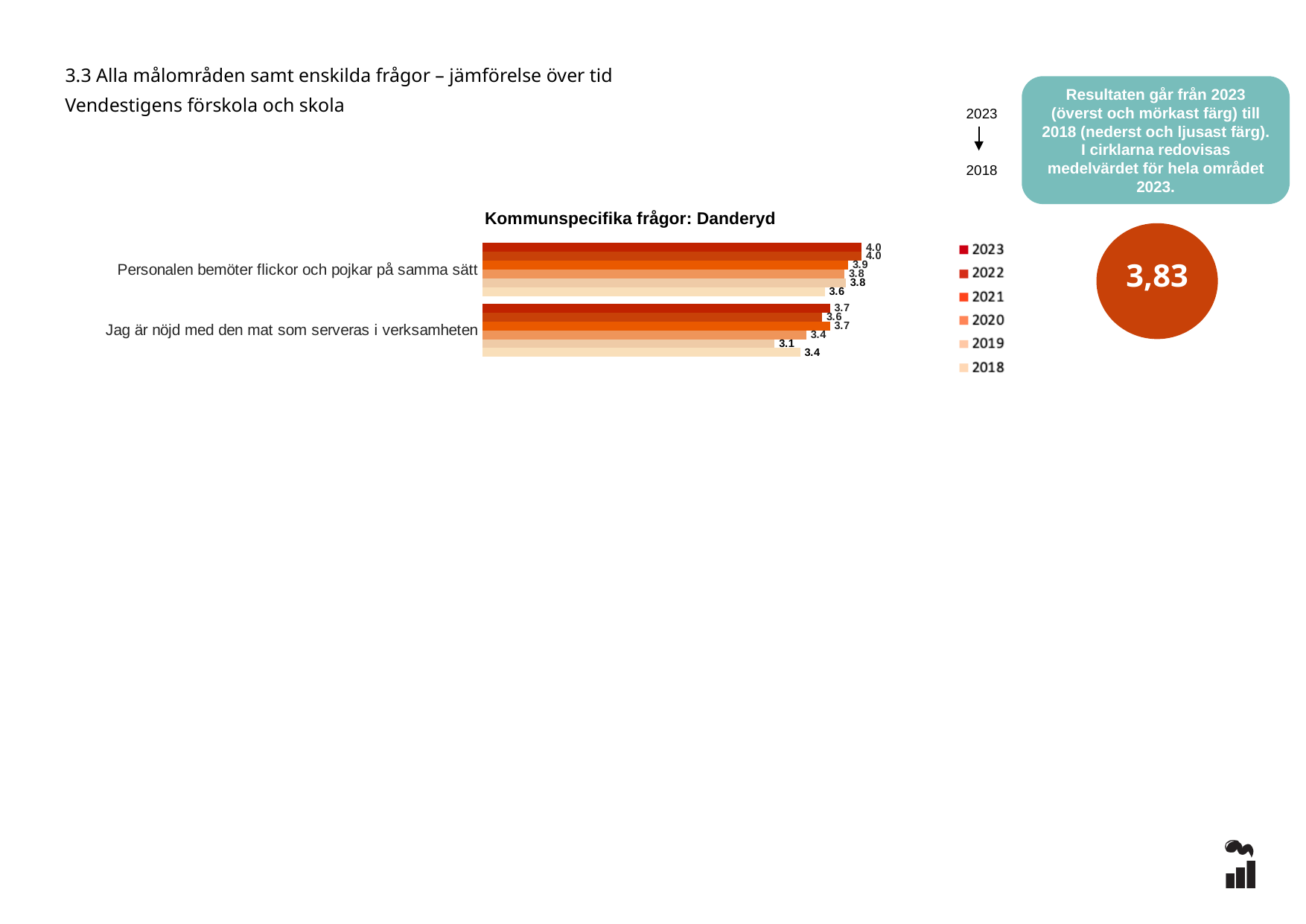
What is the 2023 value for "Jag är nöjd med den mat som serveras i verksamheten"? 3.7 How many series does the legend of the "Kommunspecifika frågor: Danderyd" chart list? 6 What is the difference between the 2023 and 2019 values for "Jag är nöjd med den mat som serveras i verksamheten"? 0.6 Which year has the lowest value for "Jag är nöjd med den mat som serveras i verksamheten"? 2019 What is the 2023 value for "Personalen bemöter flickor och pojkar på samma sätt"? 4.0 What is the 2019 value for "Jag är nöjd med den mat som serveras i verksamheten"? 3.1 Which is larger for 2023: the value for "Personalen bemöter flickor och pojkar på samma sätt" or for "Jag är nöjd med den mat som serveras i verksamheten"? Personalen bemöter flickor och pojkar på samma sätt What mean value for the whole area in 2023 is shown in the circle next to the chart? 3,83 What is the difference between the 2023 and 2018 values for "Personalen bemöter flickor och pojkar på samma sätt"? 0.4 What type of chart is shown under the title "Kommunspecifika frågor: Danderyd"? Bar chart How many categories (questions) are plotted in the "Kommunspecifika frågor: Danderyd" chart? 2 What is the 2018 value for "Personalen bemöter flickor och pojkar på samma sätt"? 3.6